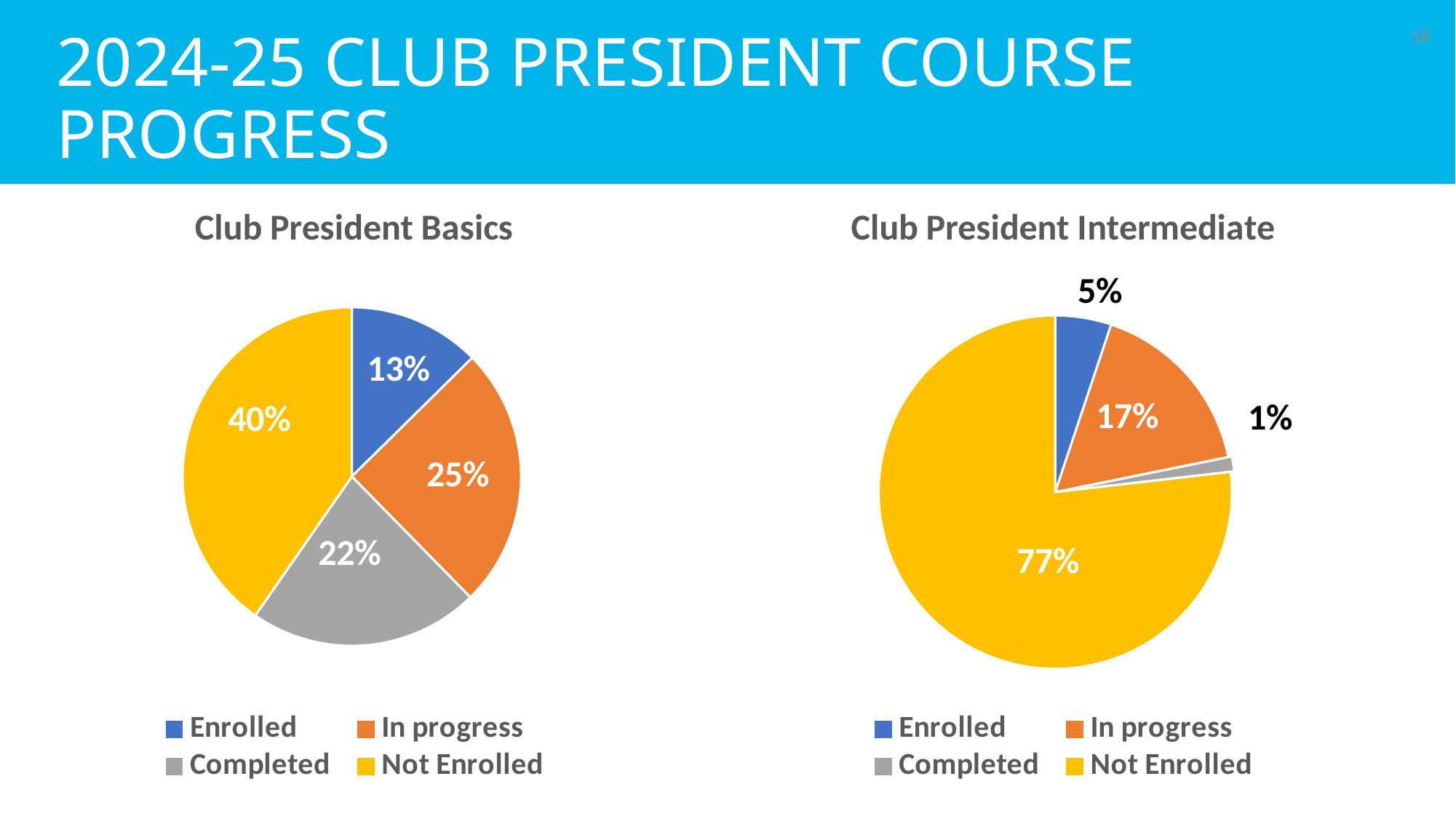
In the Club President Basics chart, what share of the pie is Not Enrolled? 40% In the Club President Basics chart, what is the value for Completed? 22% What kind of chart is the Club President Basics chart? Pie chart In the Club President Basics chart, what is the value for Enrolled? 13% In the Club President Intermediate chart, what is the value for In progress? 17% In the Club President Basics chart, which category has the smallest slice? Enrolled In the Club President Basics chart, what is the difference between In progress and Completed? 3% In the Club President Intermediate chart, which is larger, Enrolled or In progress? In progress In the Club President Basics chart, which colour represents Not Enrolled? Yellow In the Club President Intermediate chart, which category has the largest slice? Not Enrolled In the Club President Intermediate chart, what share of the pie is Completed? 1% How many categories does the Club President Intermediate chart show? 4